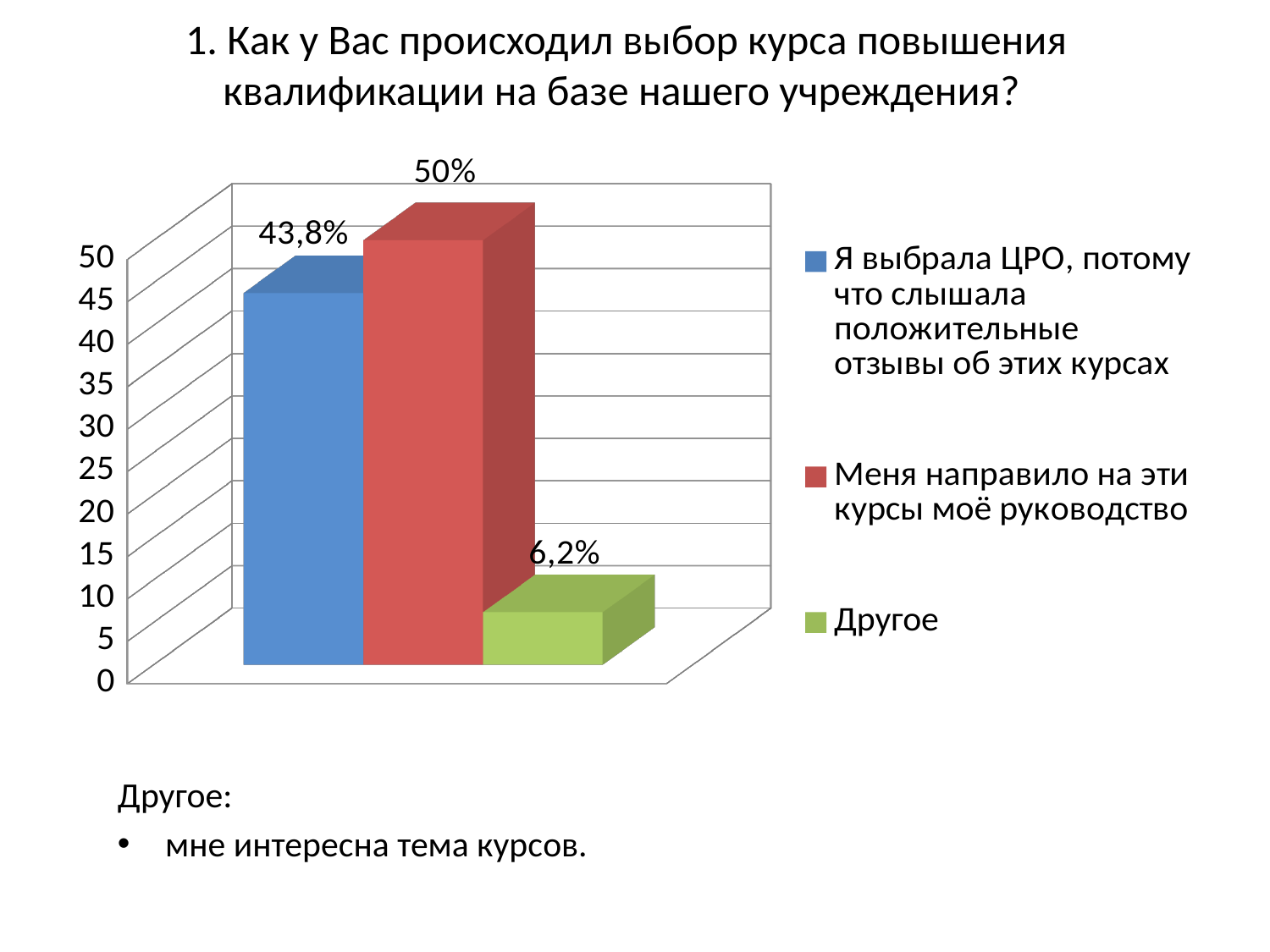
Which category has the highest value? Меня направило на эти курсы моё руководство What is the difference between the values for "Меня направило на эти курсы моё руководство" and "Я выбрала ЦРО, потому что слышала положительные отзывы об этих курсах"? 6,2% How many entries does the legend list? 3 Which is larger: the value for "Я выбрала ЦРО, потому что слышала положительные отзывы об этих курсах" or the value for "Другое"? Я выбрала ЦРО, потому что слышала положительные отзывы об этих курсах What kind of chart is shown on the slide? Bar chart What value is shown for "Другое"? 6,2% What colour is the bar for "Другое"? Green What is the difference between the values for "Я выбрала ЦРО, потому что слышала положительные отзывы об этих курсах" and "Другое"? 37,6% Which category has the lowest value? Другое What value is shown for "Я выбрала ЦРО, потому что слышала положительные отзывы об этих курсах"? 43,8% How many bars are plotted on the chart? 3 What value is shown for "Меня направило на эти курсы моё руководство"? 50%